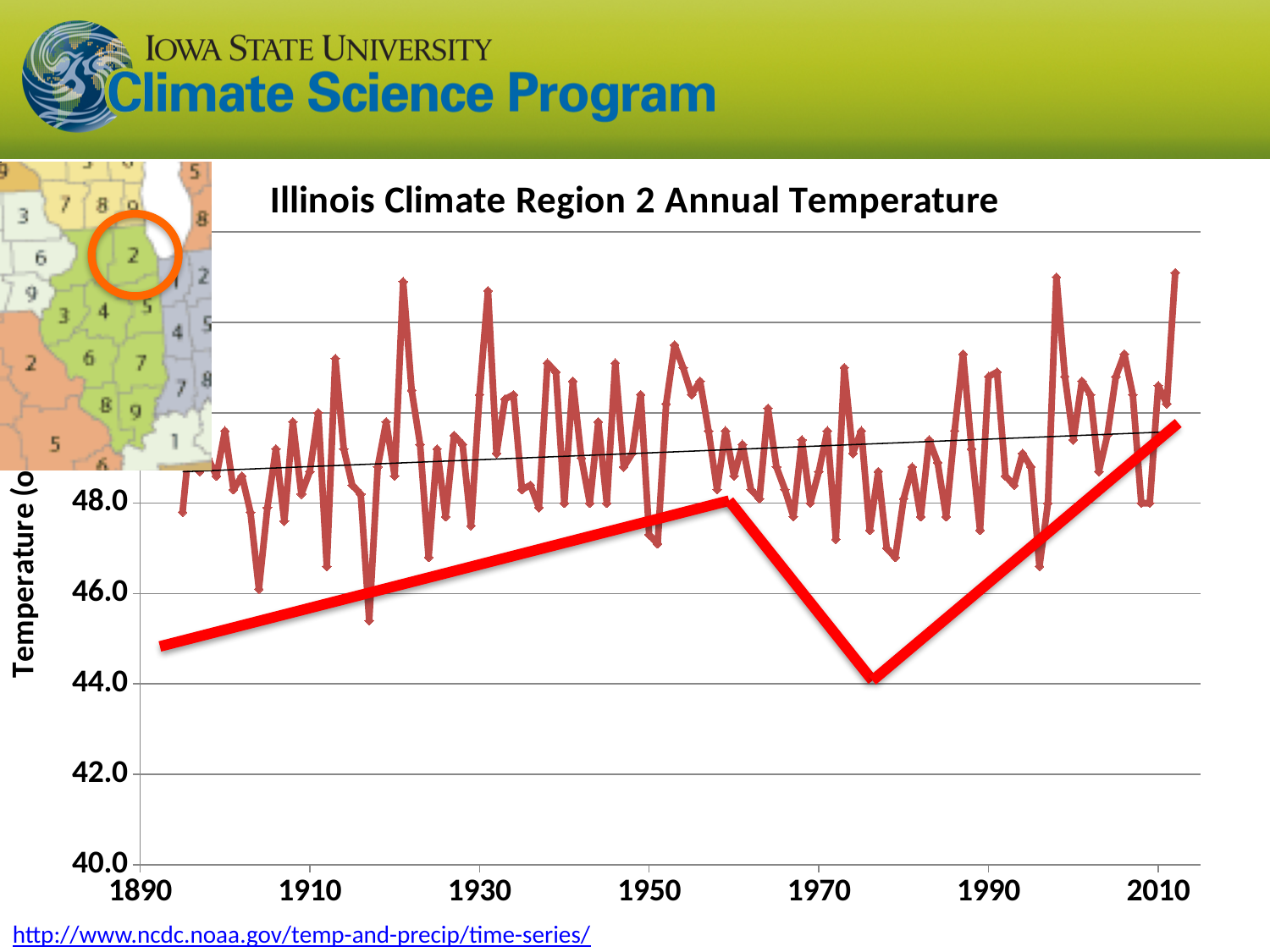
Is the annual temperature value for the dip around 1977 greater or less than 48.0? less Is the annual temperature value for the peak around 1998 greater or less than 48.0? greater What kind of chart is shown on the slide? line chart Does the thin black trend line on the chart rise or fall from 1890 to 2010? rise What is the last year labelled on the x axis of the chart? 2010 What is the first year labelled on the x axis of the chart? 1890 What is the title of the chart? Illinois Climate Region 2 Annual Temperature Is the annual temperature value for the peak around 1921 greater or less than 48.0? greater What is the lowest value labelled on the y axis of the chart? 40.0